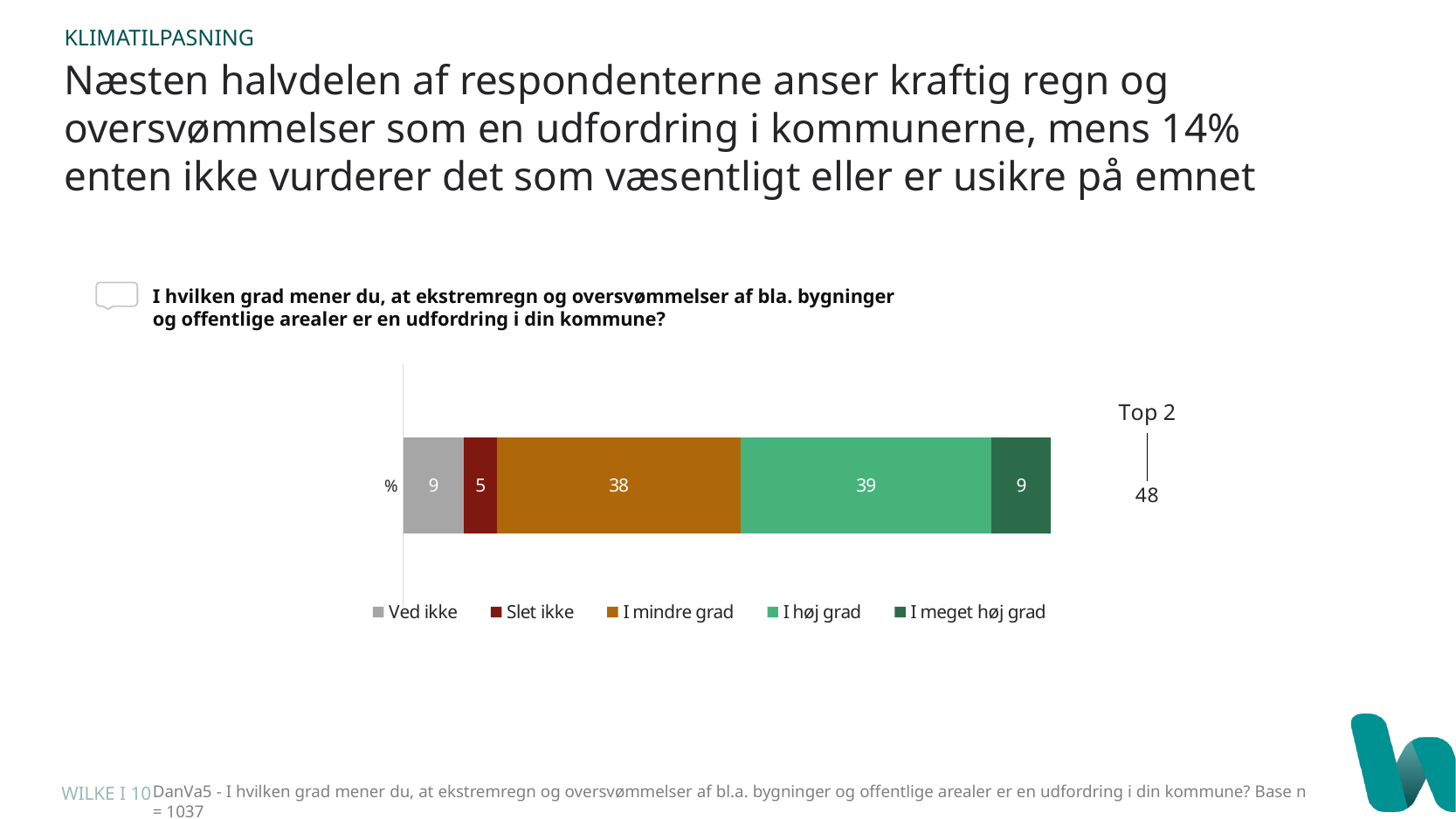
Which category has the smallest value in the bar? Slet ikke What is the value for "Ved ikke" in the bar? 9 What type of chart is shown on the slide? Stacked bar chart What is the value for "I høj grad" in the bar? 39 What is the value for "Slet ikke" in the bar? 5 What is the value for "I mindre grad" in the bar? 38 Which is larger, the value for "I meget høj grad" or the value for "Slet ikke"? I meget høj grad Which category has the largest value in the bar? I høj grad What is the Top 2 value shown to the right of the bar? 48 What is the total of all segments in the stacked bar? 100 What is the difference between the values for "I mindre grad" and "Slet ikke"? 33 How many series does the legend list? 5